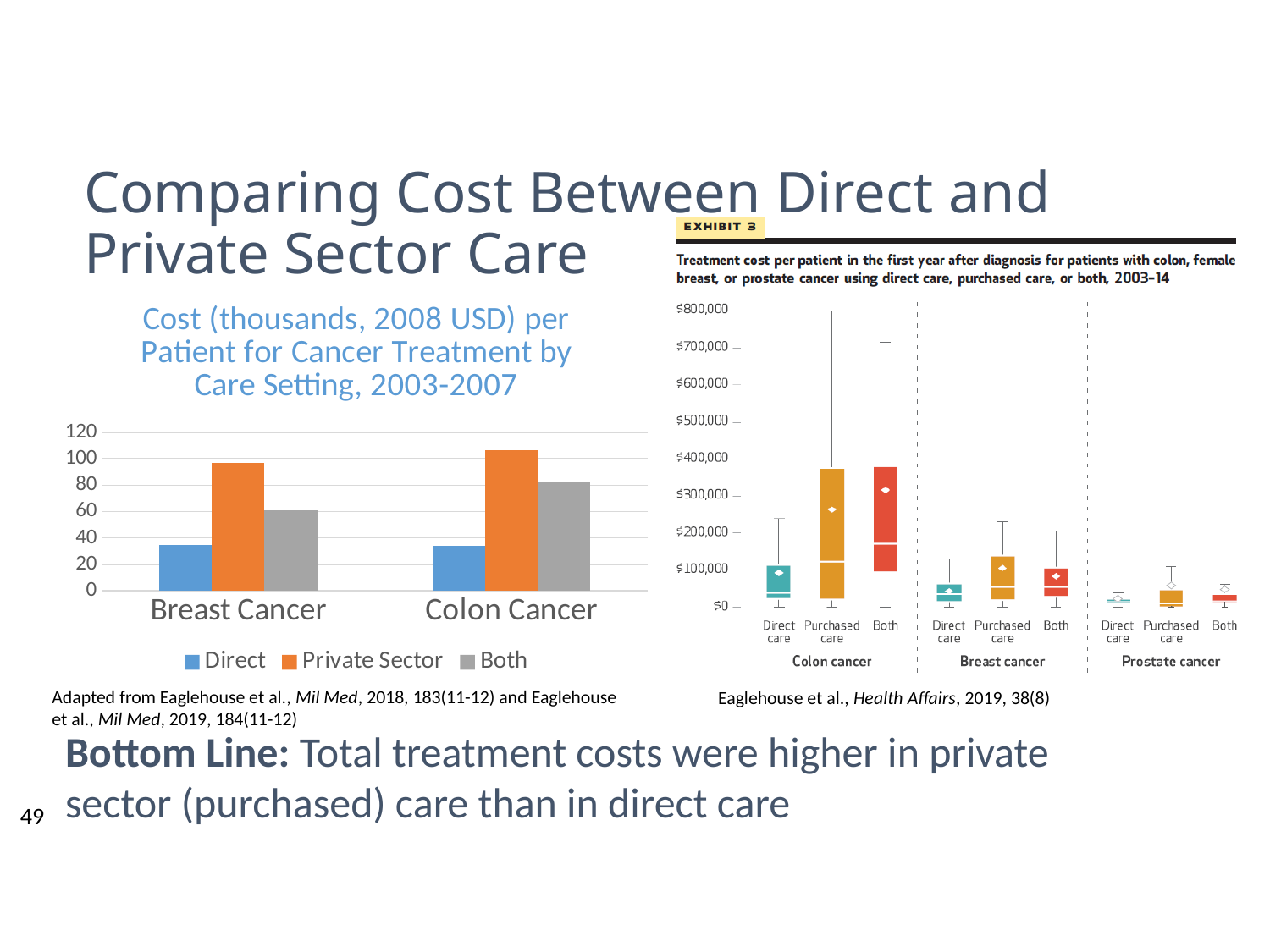
On the left chart, which series has the highest bar for Colon Cancer? Private Sector On the left chart, which is larger: the Both value for Colon Cancer or the Both value for Breast Cancer? Colon Cancer On the left chart, is the Private Sector value for Breast Cancer greater or less than 80? greater On the right chart (Exhibit 3), how many cancer types are shown along the x axis? 3 On the left chart, how many cancer categories are shown on the x axis? 2 On the left chart, is the Both value for Breast Cancer greater or less than 80? less On the left chart, is the Direct value for Breast Cancer greater or less than 40? less On the left chart, what kind of chart is it? bar chart On the left chart, what is the title? Cost (thousands, 2008 USD) per Patient for Cancer Treatment by Care Setting, 2003-2007 On the left chart, which series has the lowest bar for Breast Cancer? Direct On the left chart, how many series does the legend list? 3